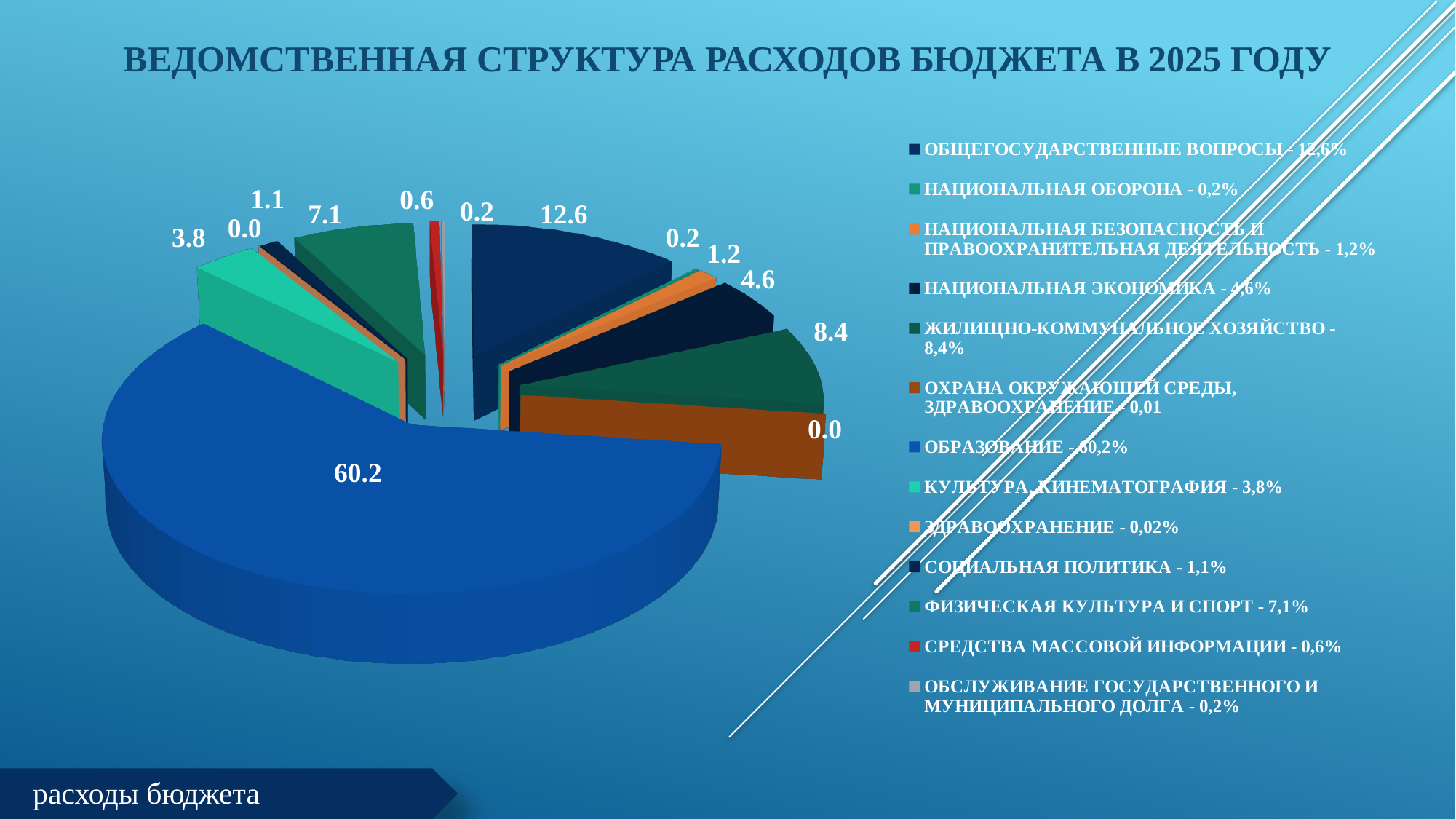
What is the data label shown for the ОБЩЕГОСУДАРСТВЕННЫЕ ВОПРОСЫ slice? 12.6 What percentage does the legend give for СРЕДСТВА МАССОВОЙ ИНФОРМАЦИИ? 0,6% How many entries does the legend list? 13 What kind of chart is shown on the slide? Pie chart What is the data label shown for the ОБРАЗОВАНИЕ slice? 60.2 What is the data label shown for the ЖИЛИЩНО-КОММУНАЛЬНОЕ ХОЗЯЙСТВО slice? 8.4 What is the data label shown for the НАЦИОНАЛЬНАЯ ЭКОНОМИКА slice? 4.6 What is the title of the chart slide? ВЕДОМСТВЕННАЯ СТРУКТУРА РАСХОДОВ БЮДЖЕТА В 2025 ГОДУ Which is larger, the slice for ЖИЛИЩНО-КОММУНАЛЬНОЕ ХОЗЯЙСТВО or the slice for ФИЗИЧЕСКАЯ КУЛЬТУРА И СПОРТ? ЖИЛИЩНО-КОММУНАЛЬНОЕ ХОЗЯЙСТВО What is the data label shown for the ФИЗИЧЕСКАЯ КУЛЬТУРА И СПОРТ slice? 7.1 What is the difference between the data labels for ОБРАЗОВАНИЕ and ОБЩЕГОСУДАРСТВЕННЫЕ ВОПРОСЫ? 47.6 Which category has the largest slice of the pie? ОБРАЗОВАНИЕ